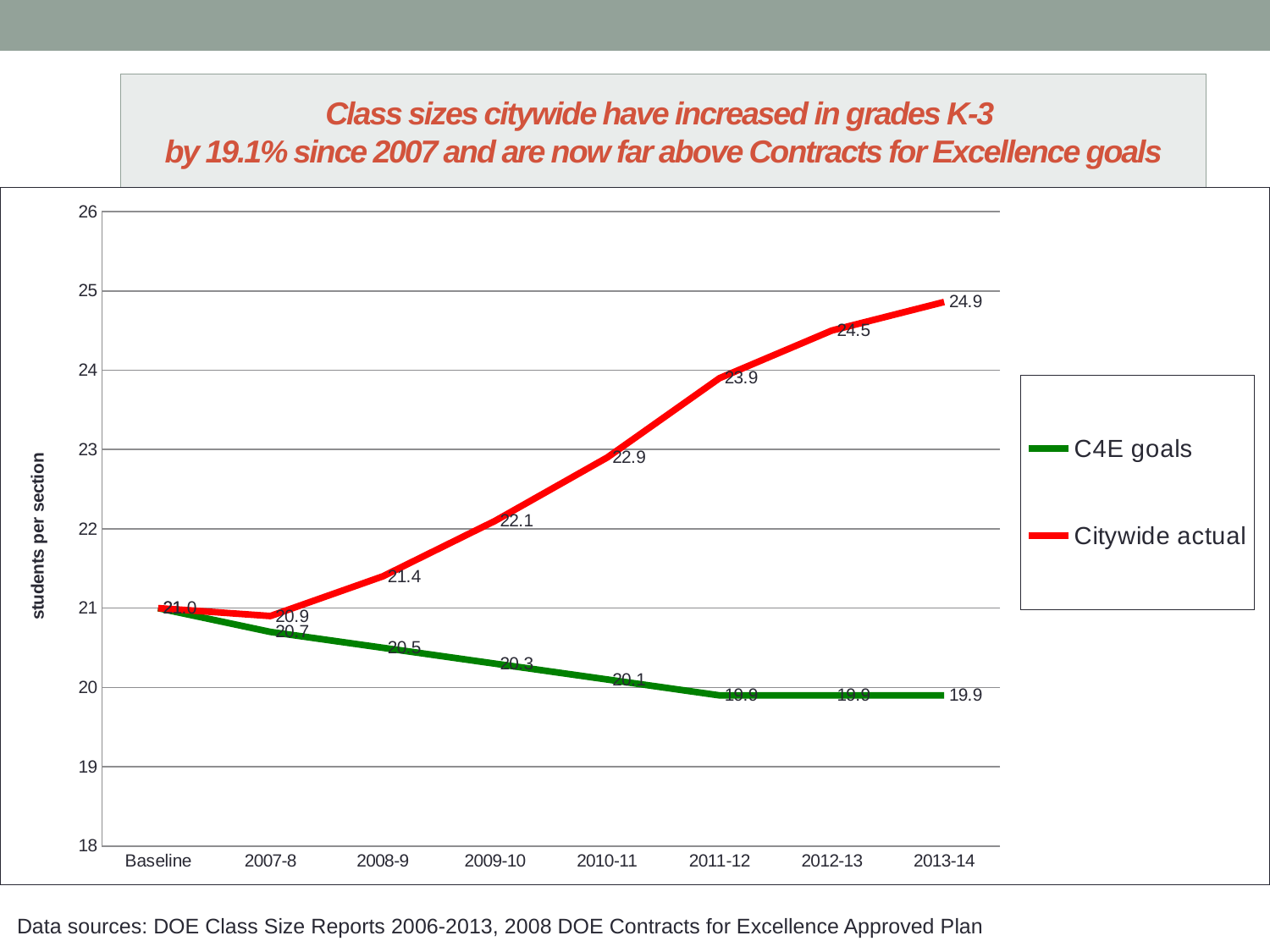
What type of chart is shown on the slide? line chart What is the C4E goals value for 2013-14? 19.9 What is the Citywide actual value for 2010-11? 22.9 What is the difference between the Citywide actual and C4E goals values in 2013-14? 5.0 What is the Citywide actual value for 2007-8? 20.9 Which is larger in 2011-12, the Citywide actual value or the C4E goals value? Citywide actual How many categories are shown on the x axis? 8 What is the Citywide actual value for 2013-14? 24.9 Does the Citywide actual series rise or fall from 2007-8 to 2013-14? rise What colour is the line for C4E goals? green How many series does the legend list? 2 In which year is the Citywide actual value highest? 2013-14